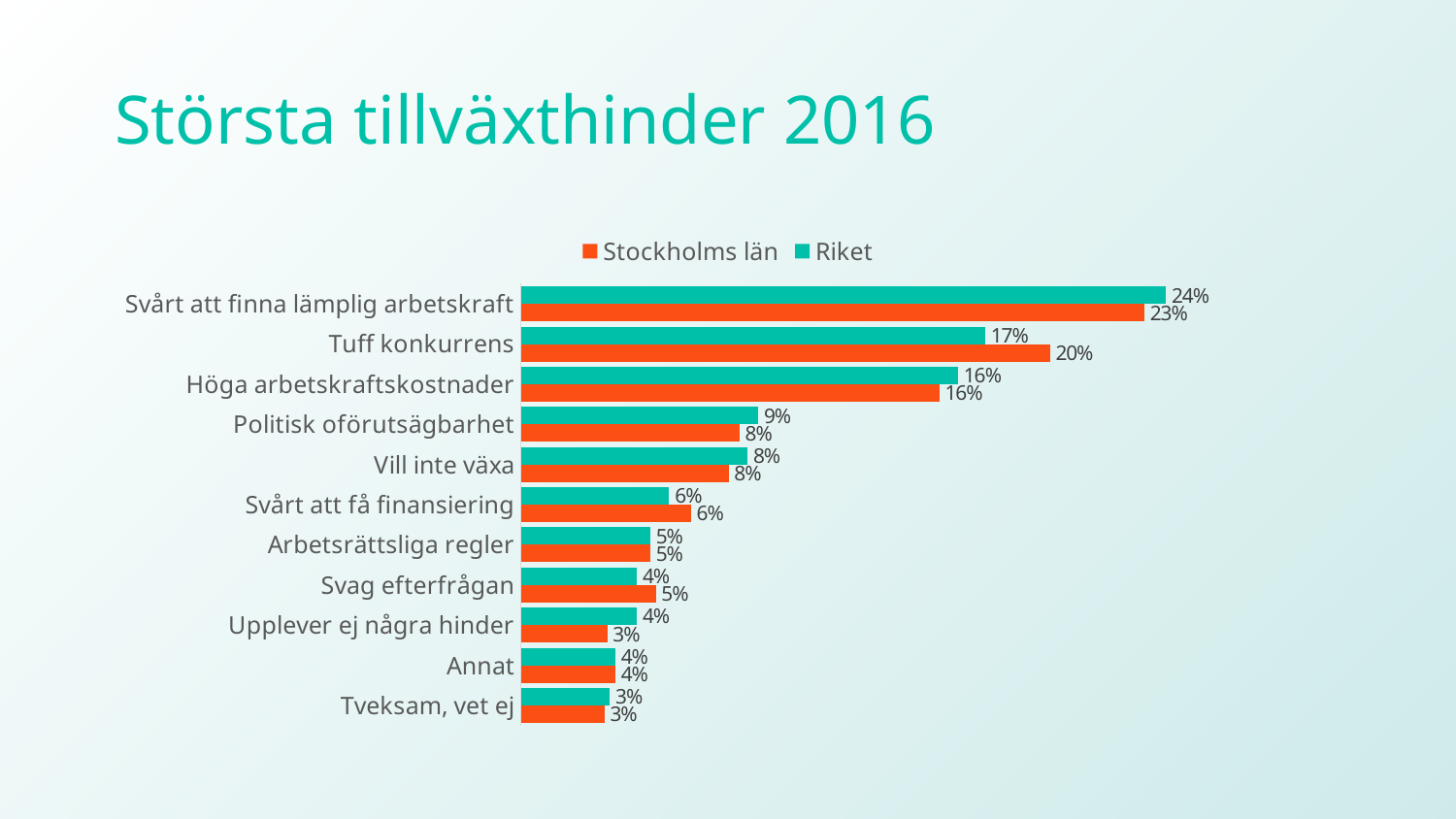
Which category has the lowest value for Riket? Tveksam, vet ej What is the value for Riket for "Svårt att finna lämplig arbetskraft"? 24% For "Svag efterfrågan", which series has the larger value, Stockholms län or Riket? Stockholms län What is the value for Stockholms län for "Tuff konkurrens"? 20% What is the value for Stockholms län for "Upplever ej några hinder"? 3% What is the difference between the Stockholms län and Riket values for "Tuff konkurrens"? 3% Which category has the highest value for Stockholms län? Svårt att finna lämplig arbetskraft How many categories are shown in the chart? 11 What is the value for Riket for "Politisk oförutsägbarhet"? 9% What kind of chart is shown on the slide? Bar chart What is the title of the slide? Största tillväxthinder 2016 How many series does the legend list? 2